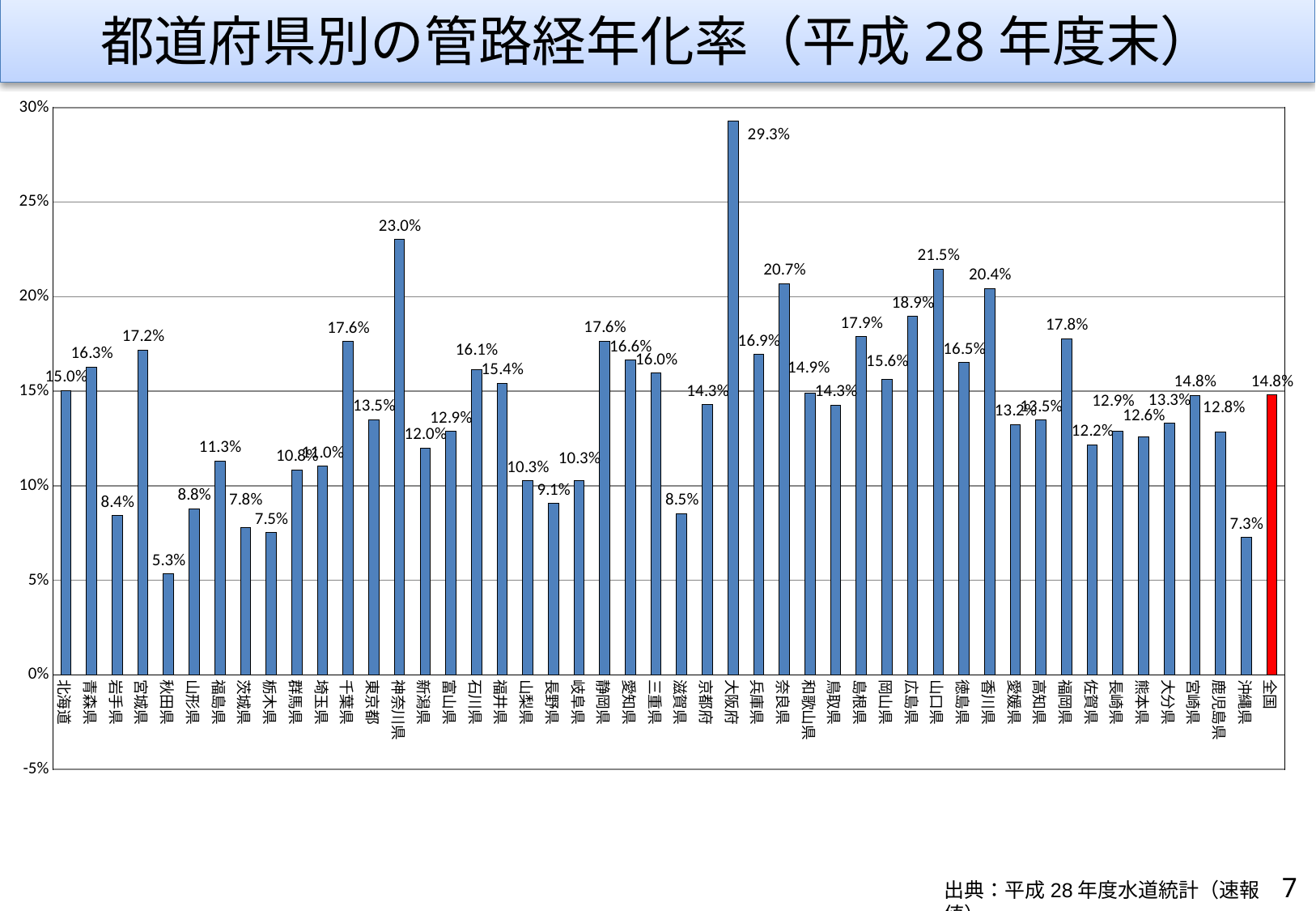
What is the value for 全国? 14.8% What is the value for 神奈川県? 23.0% What is the difference between the values for 大阪府 and 神奈川県? 6.3 percentage points How many bars are plotted in the chart? 48 Which category has the lowest value? 秋田県 Which bar is coloured red instead of blue? 全国 Which category has the highest value? 大阪府 What is the title of the slide? 都道府県別の管路経年化率（平成28年度末） Which is larger, the value for 奈良県 or the value for 山口県? 山口県 Is the value for 沖縄県 greater or less than 10%? less What kind of chart is shown on the slide? bar chart What is the value for 大阪府? 29.3%